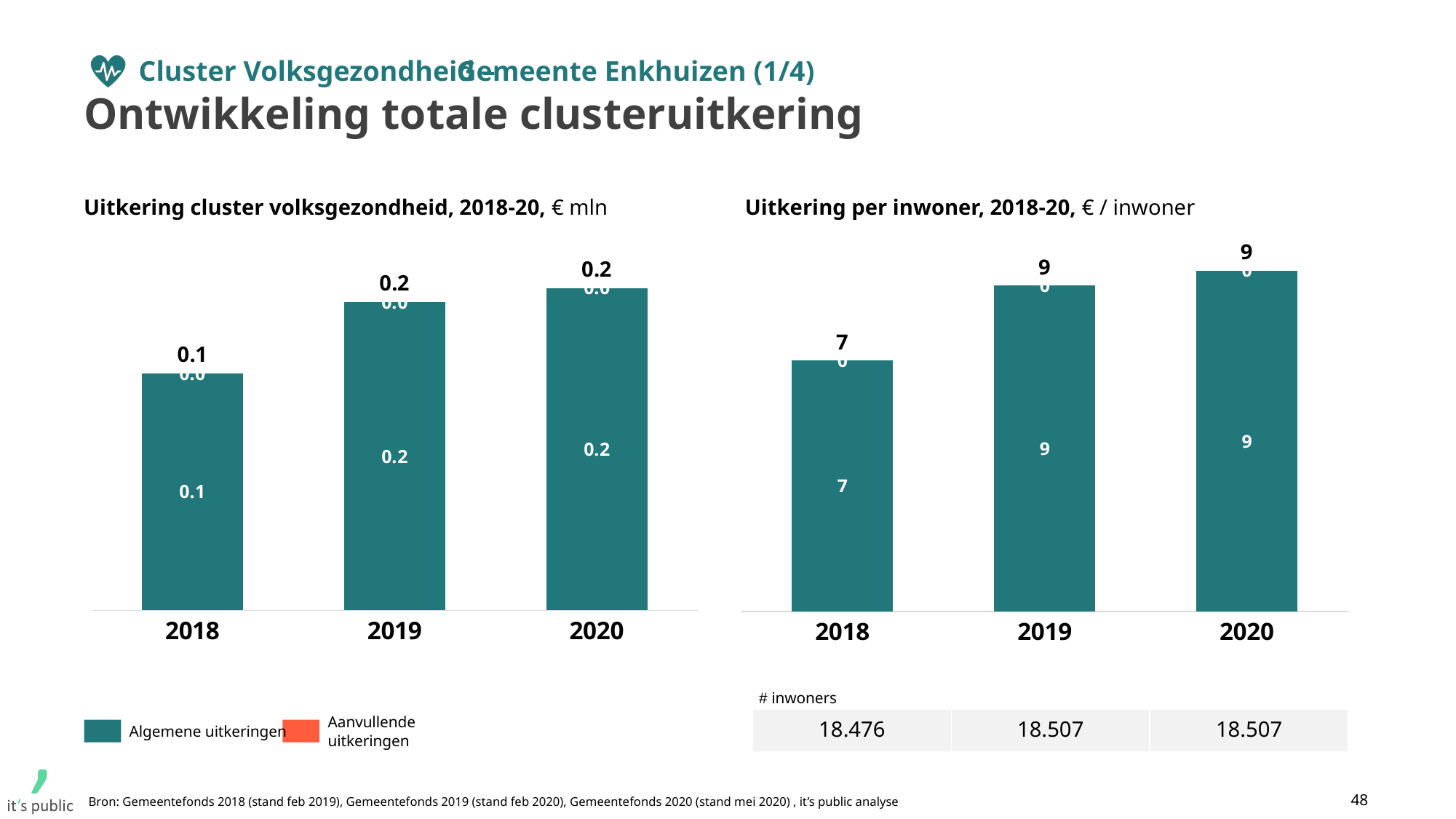
In the chart 'Uitkering cluster volksgezondheid, 2018-20', what is the total value for 2018? 0.1 In the chart 'Uitkering per inwoner, 2018-20', what is the difference between the values for 2019 and 2018? 2 In the chart 'Uitkering per inwoner, 2018-20', do the values rise or fall from 2018 to 2019? Rise In the chart 'Uitkering cluster volksgezondheid, 2018-20', what is the total value for 2020? 0.2 In the chart 'Uitkering per inwoner, 2018-20', what is the value for 2019? 9 What type of chart is 'Uitkering per inwoner, 2018-20'? Bar chart In the chart 'Uitkering per inwoner, 2018-20', which year has the lowest value? 2018 In the chart 'Uitkering cluster volksgezondheid, 2018-20', which year has the lowest total value? 2018 How many series does the legend of the left chart list? 2 How many years are shown on the x axis of the chart 'Uitkering cluster volksgezondheid, 2018-20'? 3 In the chart 'Uitkering per inwoner, 2018-20', which is larger, the value for 2018 or the value for 2020? 2020 In the chart 'Uitkering per inwoner, 2018-20', what is the value for 2018? 7